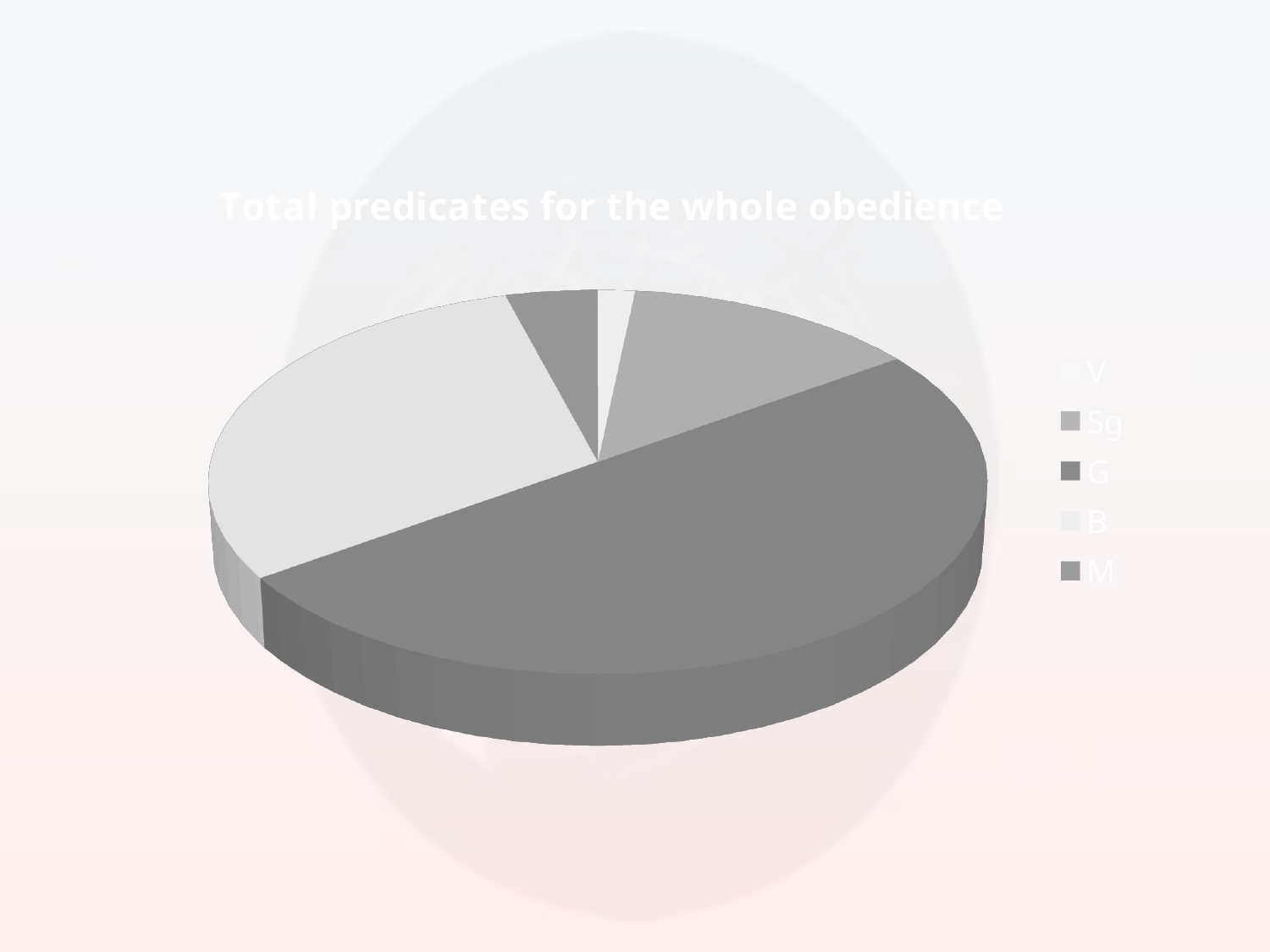
Which category has the smallest slice of the pie? V Which slice is larger, G or B? G Which slice is larger, B or Sg? B How many slices does the pie chart have? 5 Which category has the largest slice of the pie? G Which slice is larger, M or V? M What kind of chart is shown on the slide? pie chart Which category is listed first in the legend? V How many entries does the legend list? 5 What is the title of the chart? Total predicates for the whole obedience